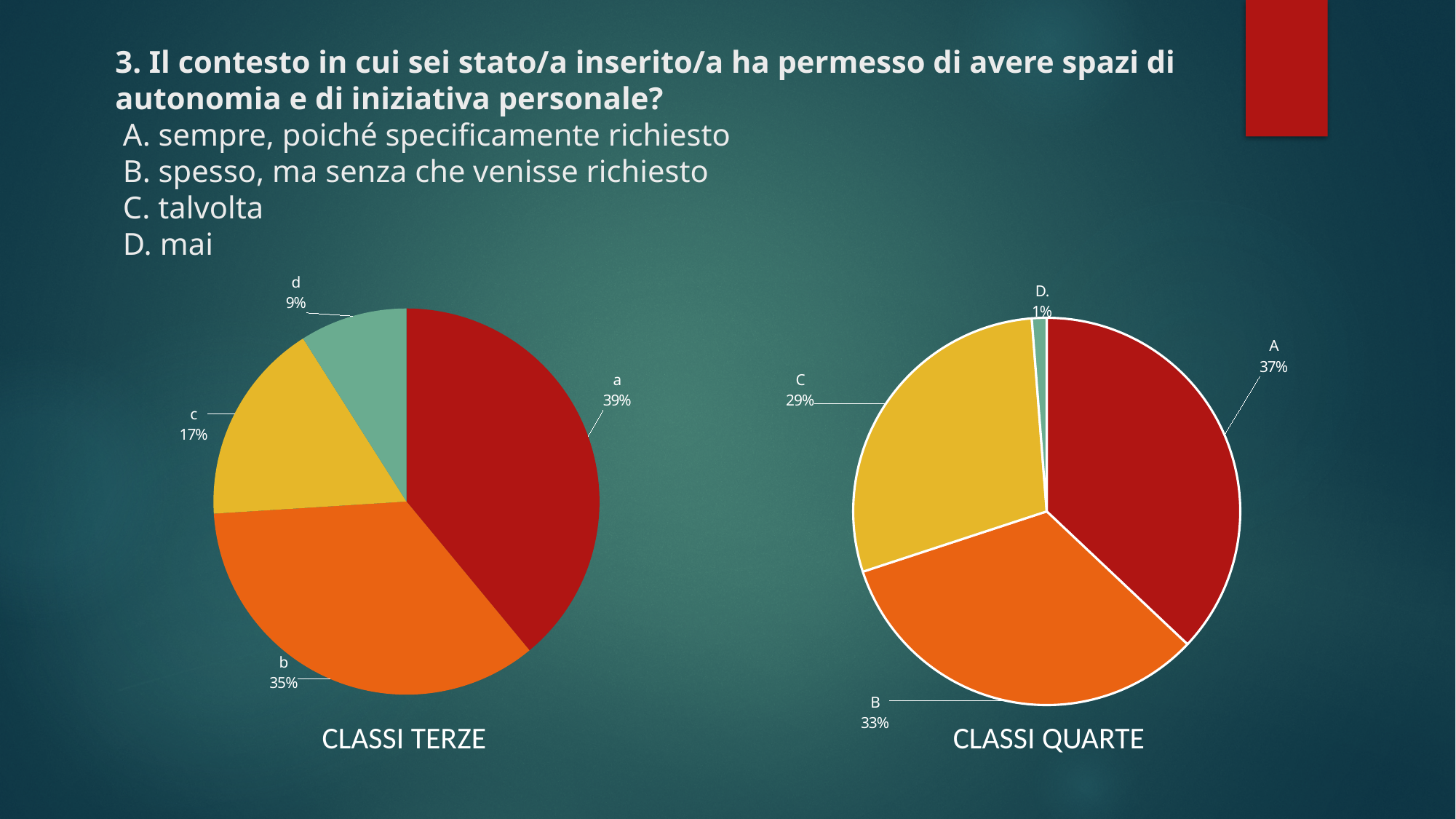
In the CLASSI TERZE pie chart, what share does slice a have? 39% In the CLASSI QUARTE pie chart, which slice is the smallest? D. In the CLASSI QUARTE pie chart, what share does slice B have? 33% What kind of chart is the CLASSI TERZE chart? Pie chart In the CLASSI TERZE pie chart, what is the difference between slice a and slice b? 4% In the CLASSI QUARTE pie chart, what share does slice D. have? 1% In the CLASSI TERZE pie chart, which slice is the largest? a In the CLASSI TERZE pie chart, which slice is the smallest? d In the CLASSI QUARTE pie chart, what is the difference between slice A and slice C? 8% In the CLASSI QUARTE pie chart, which slice is the largest? A In the CLASSI TERZE pie chart, what share does slice c have? 17% How many slices does the CLASSI QUARTE pie chart have? 4